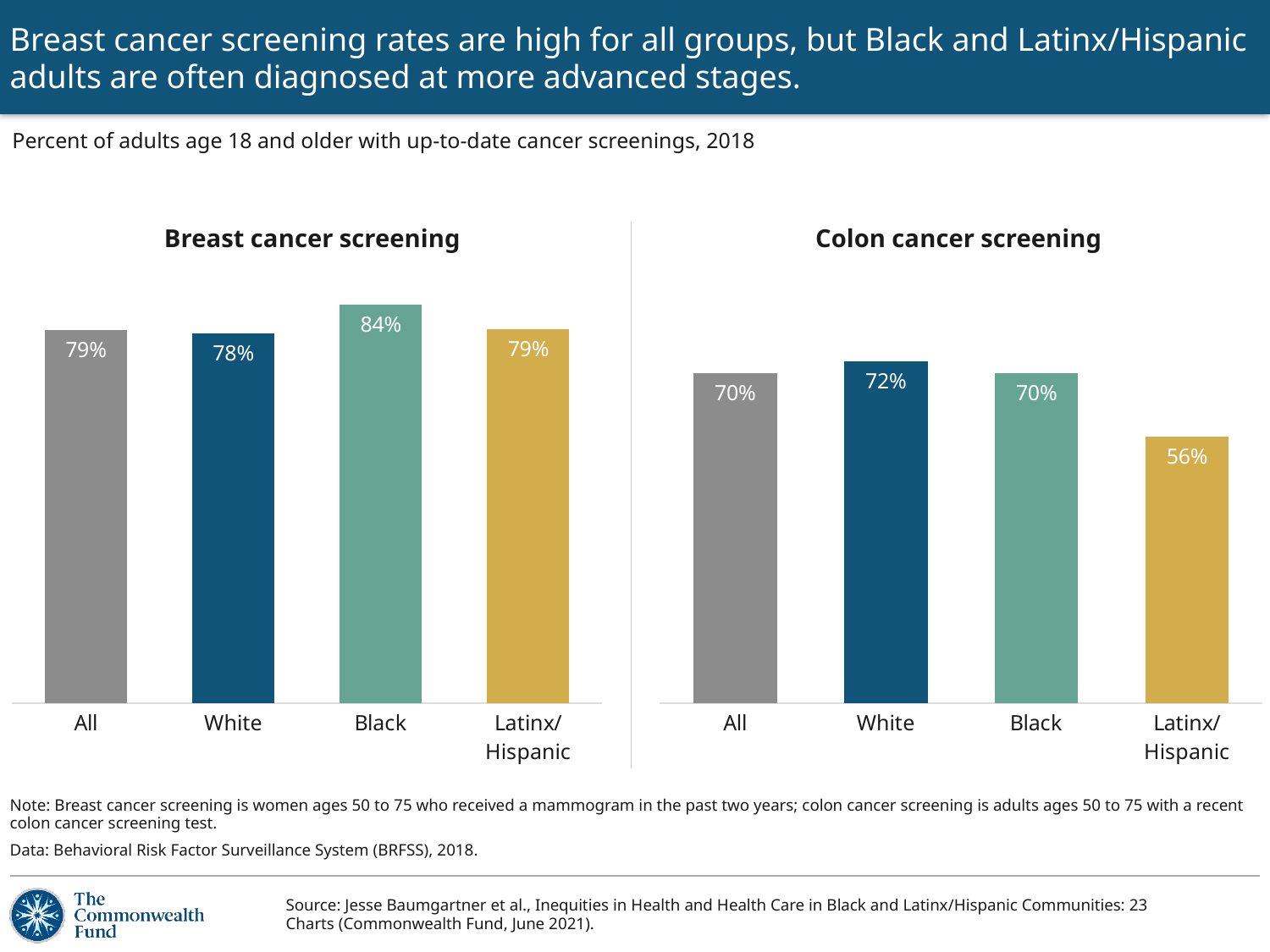
In the Colon cancer screening chart, which is larger, the value for White or the value for Latinx/Hispanic? White What type of chart is the Colon cancer screening chart? Bar chart In the Colon cancer screening chart, what is the difference between the values for White and Latinx/Hispanic? 16 percentage points In the Breast cancer screening chart, which group has the highest value? Black In the Colon cancer screening chart, which group has the lowest value? Latinx/Hispanic In the Breast cancer screening chart, what is the value for White? 78% In the Breast cancer screening chart, what is the difference between the values for Black and White? 6 percentage points In the Colon cancer screening chart, which group has the highest value? White How many groups are shown in the Breast cancer screening chart? 4 In the Colon cancer screening chart, what is the value for All? 70% In the Breast cancer screening chart, what is the value for Black? 84% In the Colon cancer screening chart, what is the value for Latinx/Hispanic? 56%